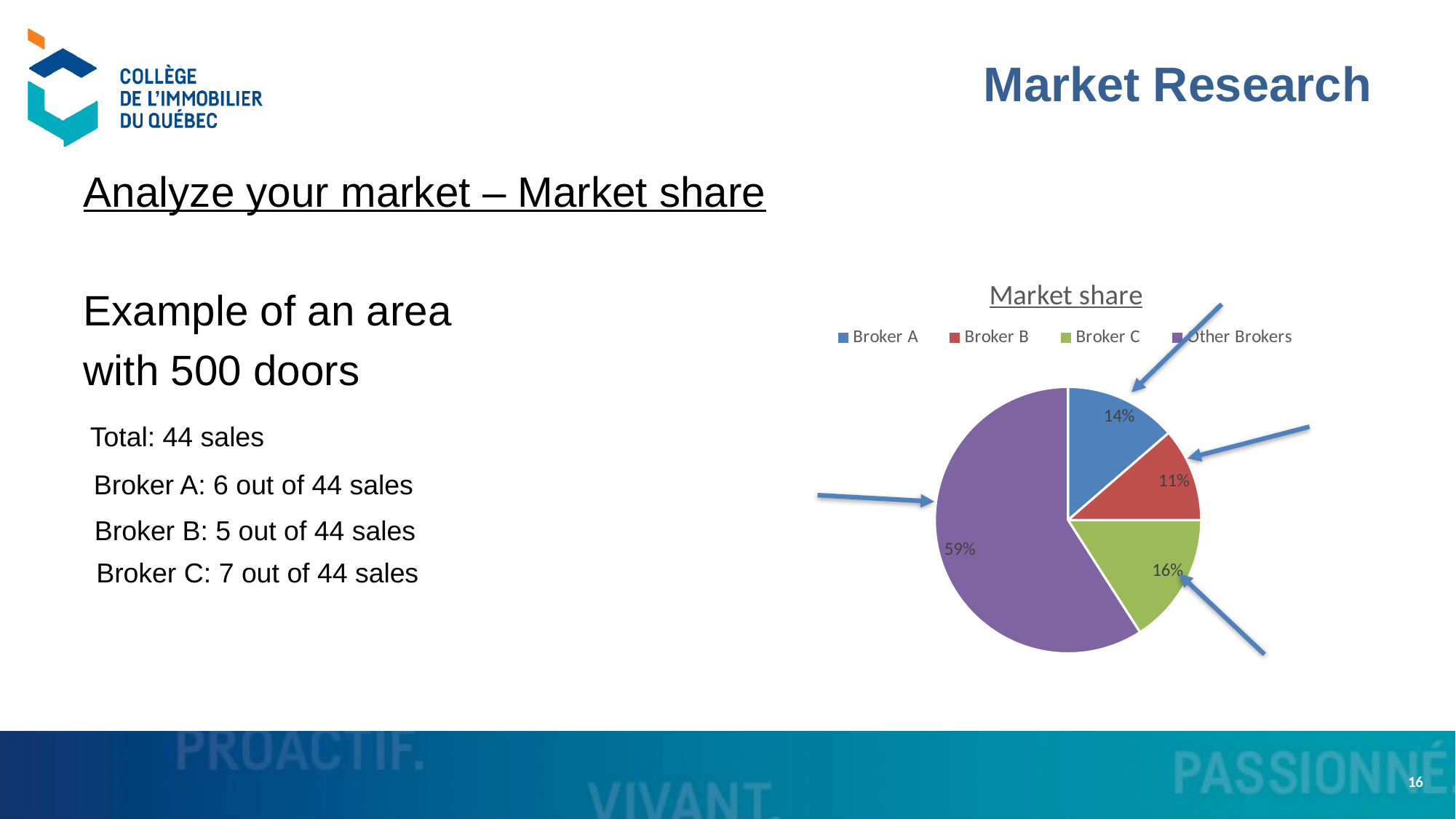
What kind of chart is shown on the slide? pie chart Which has a larger share, Broker A or Broker C? Broker C What share of the pie does Broker A have? 14% What share of the pie does Broker C have? 16% What is the title of the chart? Market share Which category has the largest slice of the pie? Other Brokers What is the difference in percentage points between the Other Brokers slice and the Broker C slice? 43 How many entries does the chart legend list? 4 What share of the pie does Broker B have? 11% How many slices does the pie chart have? 4 Which category has the smallest slice of the pie? Broker B